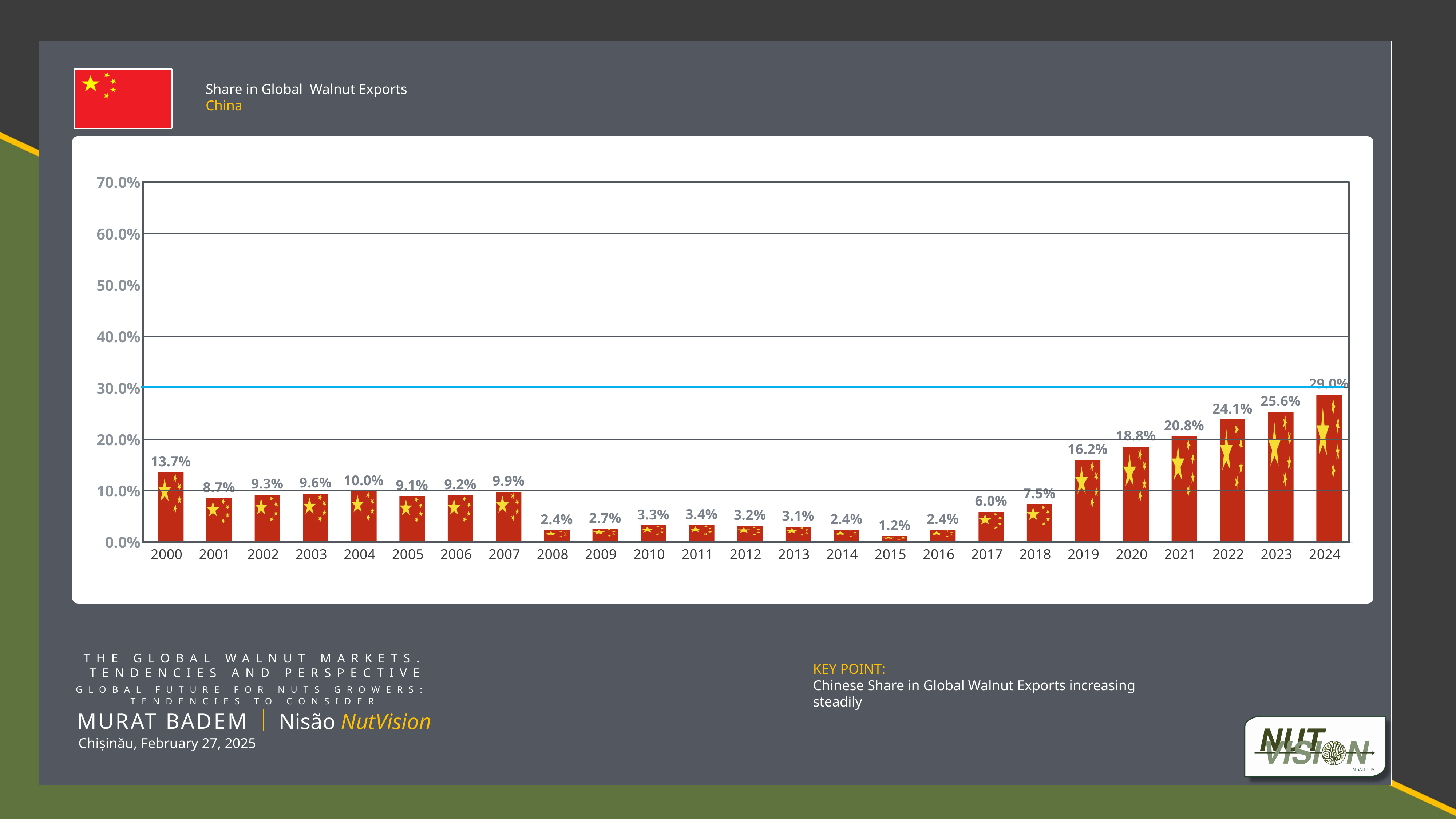
What is China's share in global walnut exports in 2000? 13.7% Which year has a larger value, 2004 or 2007? 2004 Do the values rise or fall from 2015 to 2024? rise What is China's share in global walnut exports in 2024? 29.0% How many years are shown on the x axis? 25 What is the value shown for 2019? 16.2% Is the value for 2022 greater or less than 20.0%? greater Which year has the highest share in global walnut exports? 2024 What is the value shown for 2015? 1.2% What is the difference between the 2024 value and the 2023 value? 3.4% What kind of chart is shown on the slide? bar chart Which year has the lowest share in global walnut exports? 2015